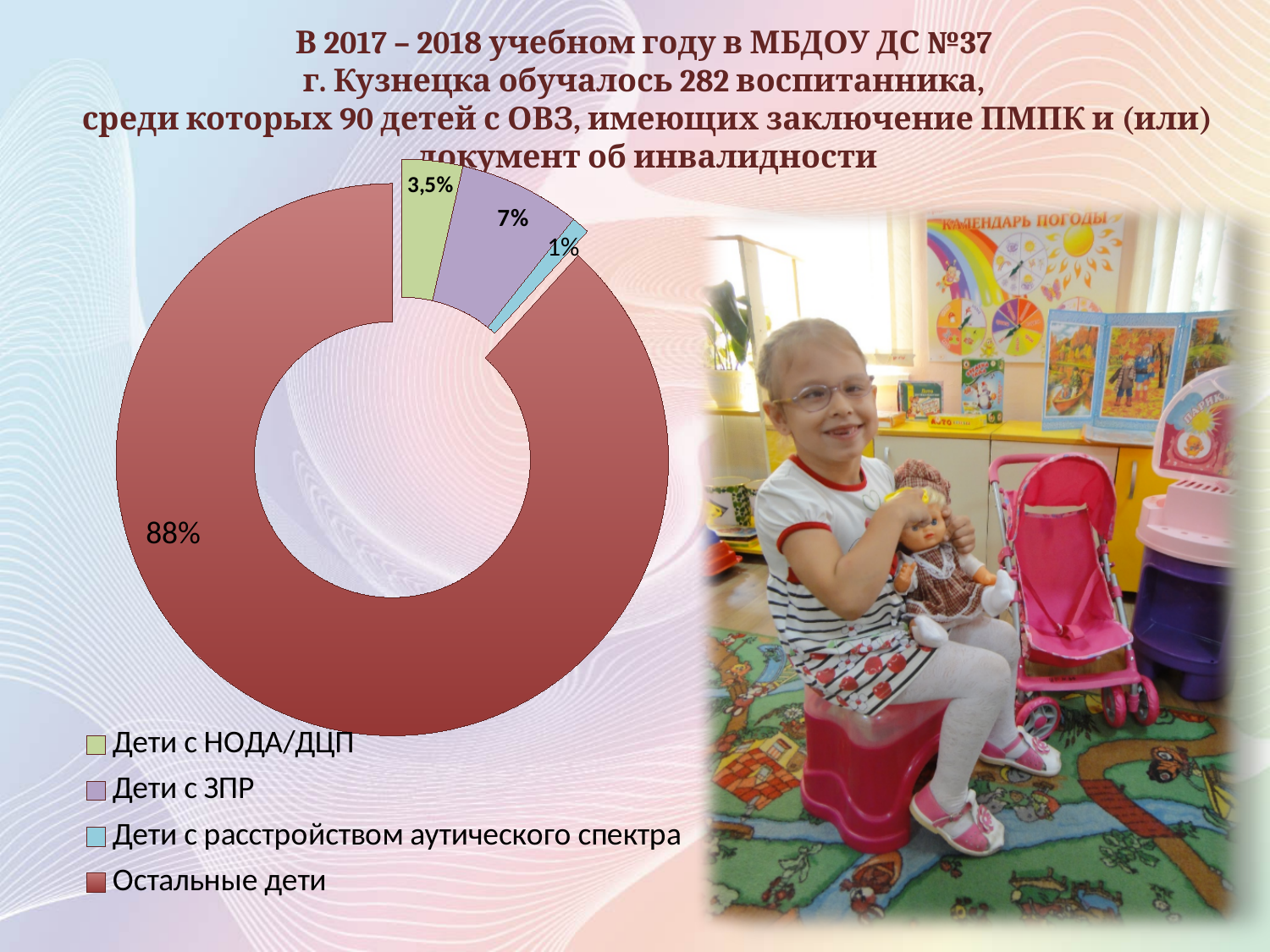
Which is larger: the share for Дети с ЗПР or the share for Дети с НОДА/ДЦП? Дети с ЗПР What is the difference in percentage points between Дети с ЗПР and Дети с расстройством аутического спектра? 6 What kind of chart is shown on the slide? Doughnut chart How many categories does the chart show? 4 What colour is the segment for Дети с расстройством аутического спектра? Light blue What share of the chart is labelled for Дети с ЗПР? 7% What percentage is shown for Остальные дети? 88% What is the difference in percentage points between Остальные дети and Дети с ЗПР? 81 Which category has the smallest share of the chart? Дети с расстройством аутического спектра Which category has the largest share of the chart? Остальные дети What percentage is shown for Дети с расстройством аутического спектра? 1% What percentage is shown for Дети с НОДА/ДЦП? 3,5%